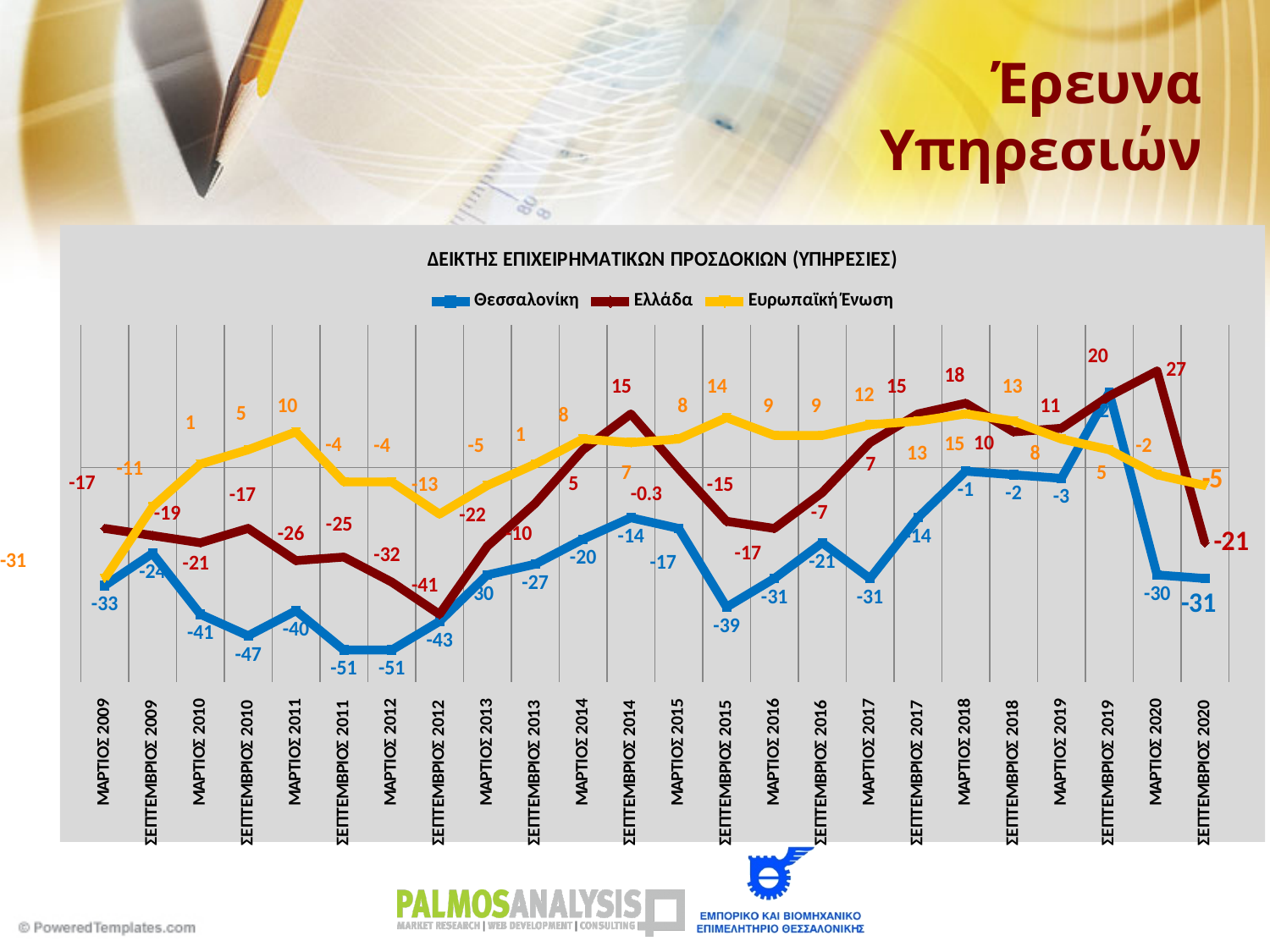
What is the difference between the Ελλάδα values in ΜΑΡΤΙΟΣ 2020 and ΣΕΠΤΕΜΒΡΙΟΣ 2020? 48 In which period does Ελλάδα reach its highest value? ΜΑΡΤΙΟΣ 2020 In ΣΕΠΤΕΜΒΡΙΟΣ 2020, which is higher: Ελλάδα or Θεσσαλονίκη? Ελλάδα What is the lowest value reached by Θεσσαλονίκη? -51 What is the value for Ελλάδα in ΣΕΠΤΕΜΒΡΙΟΣ 2012? -41 What is the value for Ελλάδα in ΜΑΡΤΙΟΣ 2020? 27 What kind of chart is shown on the slide? Line chart What colour is the Θεσσαλονίκη line? Blue What is the value for Θεσσαλονίκη in ΣΕΠΤΕΜΒΡΙΟΣ 2020? -31 How many time points are shown on the x axis? 24 How many series does the legend list? 3 What is the value for Ευρωπαϊκή Ένωση in ΜΑΡΤΙΟΣ 2011? 10